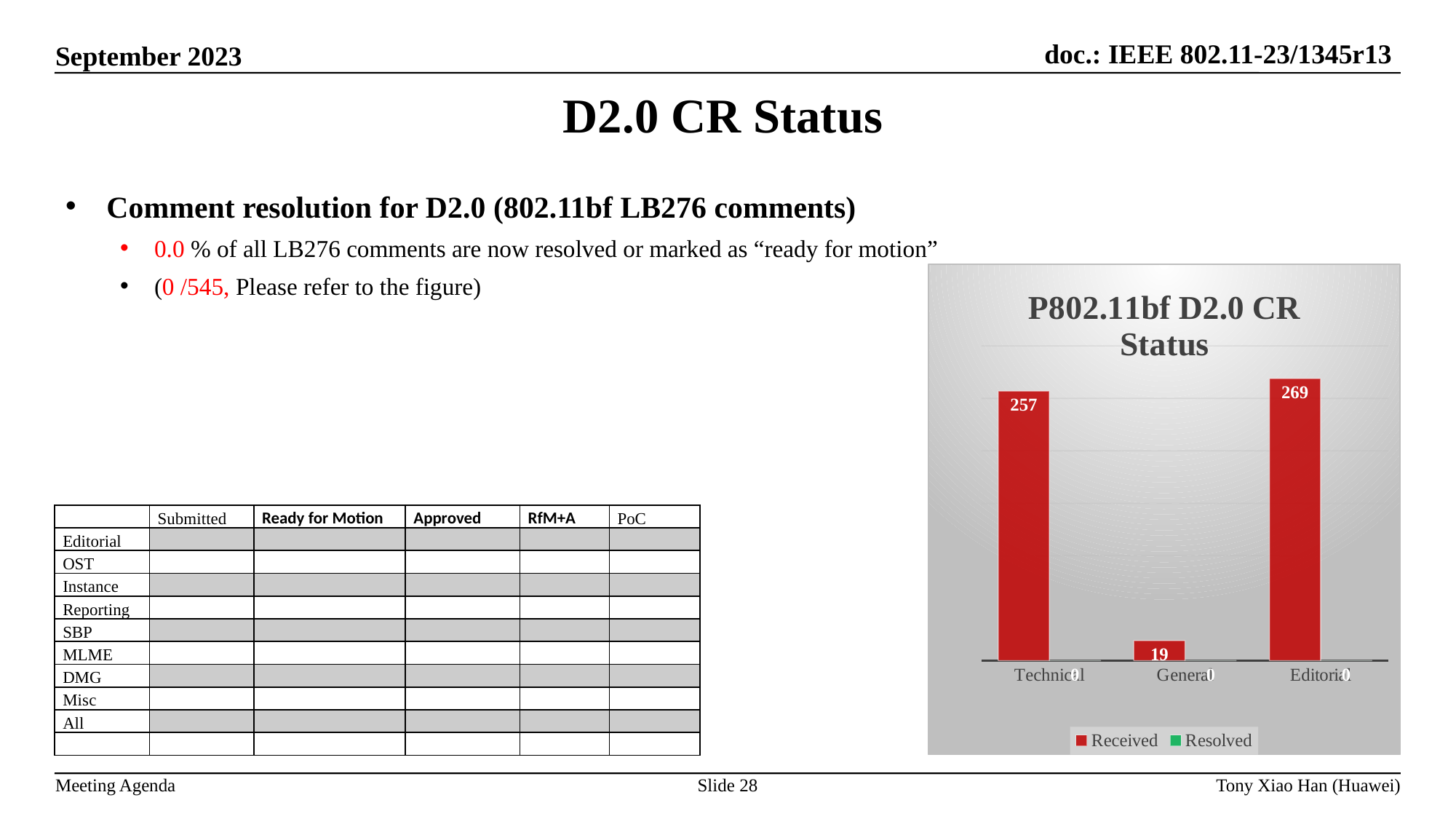
How many series does the chart legend list? 2 What is the difference between the Received values for Editorial and Technical? 12 Which category has the highest Received value? Editorial Which category has the lowest Received value? General What is the Received value for Editorial? 269 Which is larger, the Received value for Technical or for General? Technical How many categories are shown on the x axis of the chart? 3 What type of chart is shown on the slide? bar chart What are the two series named in the chart legend? Received and Resolved What is the title of the chart? P802.11bf D2.0 CR Status What is the Received value for General? 19 What is the Received value for Technical? 257